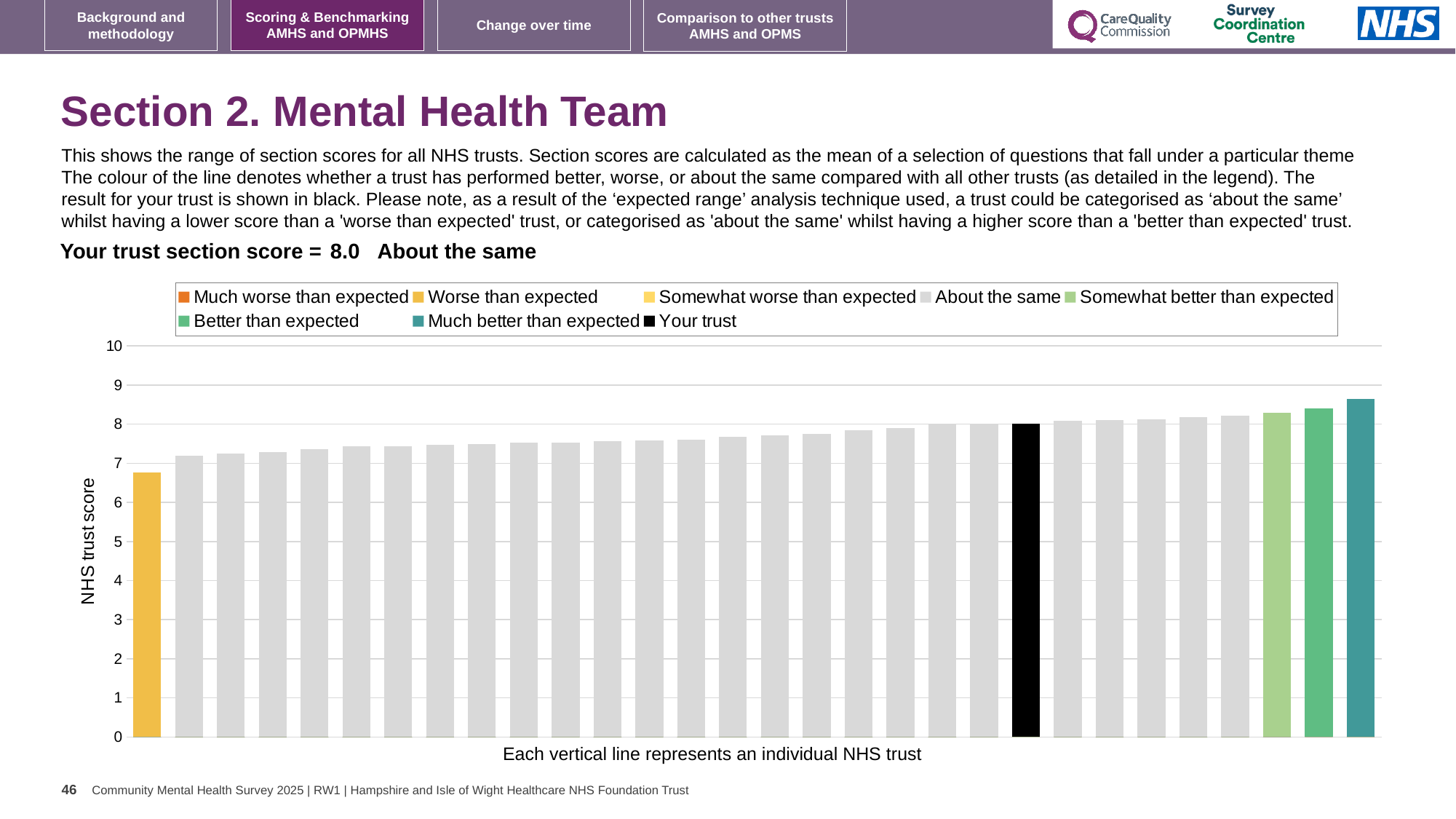
What is the section score for your trust shown on the slide? 8.0 Is the value of the black 'Your trust' bar greater or less than 7? greater What colour is the bar representing your trust? black What is the label on the vertical axis of the chart? NHS trust score Is the value of the leftmost (yellow) bar greater or less than 7? less How many entries does the chart legend list? 8 Do the bar values rise or fall from left to right across the chart? rise What kind of chart is shown on the slide? bar chart Which is larger: the black 'Your trust' bar or the yellow 'Worse than expected' bar? the black 'Your trust' bar Is the value of the rightmost (teal) bar greater or less than 8? greater Which legend category does the lowest bar in the chart belong to? Worse than expected Which legend category does the highest bar in the chart belong to? Much better than expected